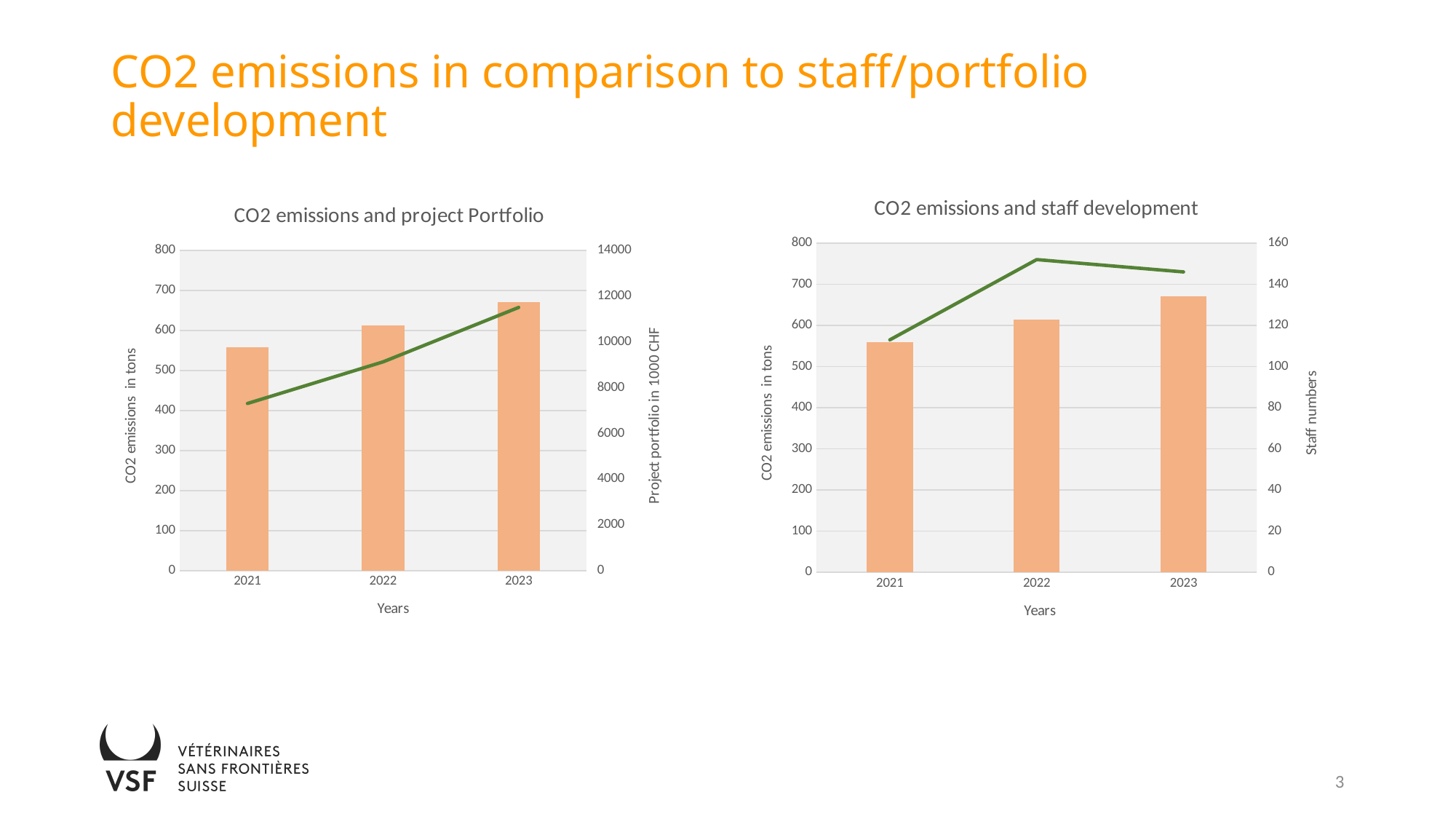
In the 'CO2 emissions and staff development' chart, is the staff number for 2021 greater or less than 120? less In the 'CO2 emissions and staff development' chart, which year has the highest staff number? 2022 In the 'CO2 emissions and project Portfolio' chart, is the project portfolio value for 2023 greater or less than 10000? greater What is the label of the right-hand vertical axis in the 'CO2 emissions and staff development' chart? Staff numbers In the 'CO2 emissions and staff development' chart, is the CO2 emissions value for 2023 greater or less than 600? greater In the 'CO2 emissions and staff development' chart, which is larger, the CO2 emissions bar for 2022 or for 2021? 2022 In the 'CO2 emissions and project Portfolio' chart, which year has the lowest CO2 emissions bar? 2021 In the 'CO2 emissions and project Portfolio' chart, do the project portfolio values rise or fall from 2021 to 2023? rise In the 'CO2 emissions and project Portfolio' chart, which year has the highest CO2 emissions bar? 2023 How many years are shown on the x axis of the 'CO2 emissions and project Portfolio' chart? 3